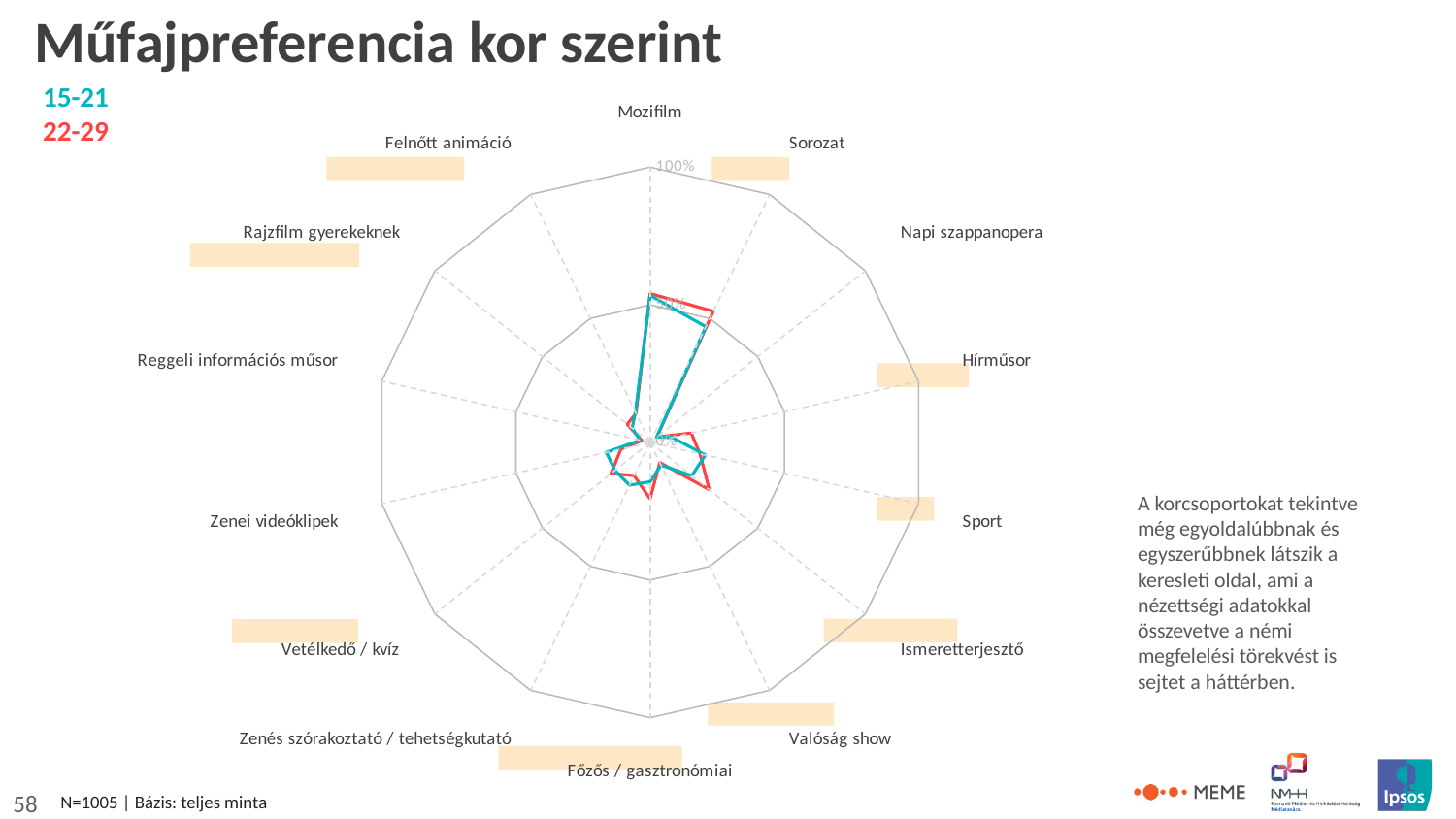
Is the value for Sport for the 22-29 group greater or less than 50%? less Is the value for Ismeretterjesztő for the 22-29 group greater or less than 50%? less What kind of chart is shown on the slide? Radar chart Is the value for Mozifilm for the 15-21 group greater or less than 100%? less How many series does the legend list? 2 For the 15-21 group, which is larger: Mozifilm or Sport? Mozifilm For the 15-21 group, which is larger: Mozifilm or Rajzfilm gyerekeknek? Mozifilm Which two age groups are compared in the chart? 15-21 and 22-29 For the 22-29 group, which is larger: Sorozat or Hírműsor? Sorozat How many genre categories are plotted on the radar chart? 14 What is the title of the slide? Műfajpreferencia kor szerint